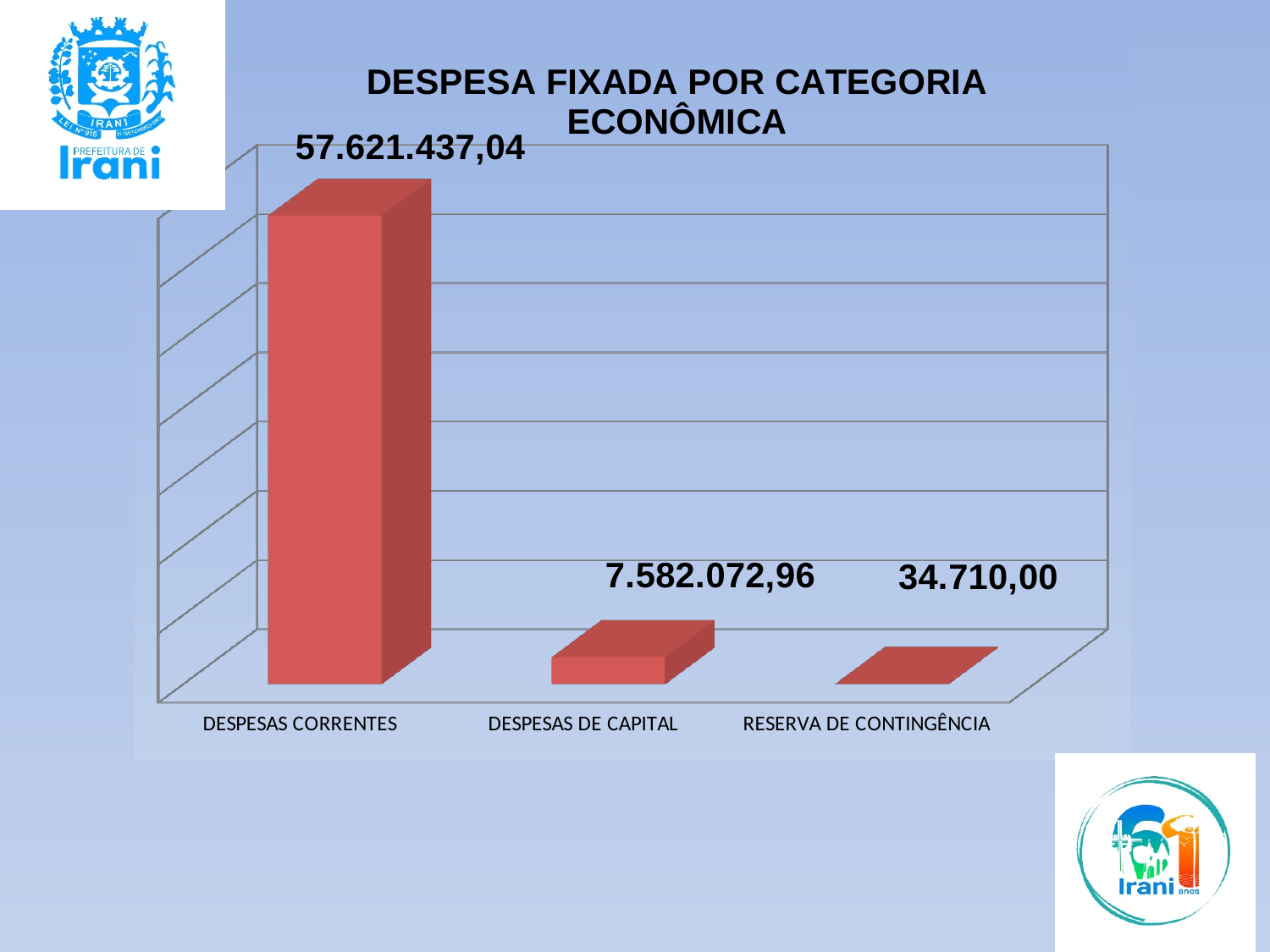
What is the difference between the values for DESPESAS DE CAPITAL and RESERVA DE CONTINGÊNCIA? 7.547.362,96 What is the difference between the values for DESPESAS CORRENTES and DESPESAS DE CAPITAL? 50.039.364,08 What is the value for DESPESAS DE CAPITAL? 7.582.072,96 Which category has the lowest value? RESERVA DE CONTINGÊNCIA What is the value for RESERVA DE CONTINGÊNCIA? 34.710,00 What is the title of the chart? DESPESA FIXADA POR CATEGORIA ECONÔMICA Do the values rise or fall from left to right across the categories? Fall Which category has the highest value? DESPESAS CORRENTES Which is larger, the value for DESPESAS DE CAPITAL or the value for RESERVA DE CONTINGÊNCIA? DESPESAS DE CAPITAL What is the value for DESPESAS CORRENTES? 57.621.437,04 How many categories are shown in the chart? 3 What kind of chart is shown on the slide? Bar chart